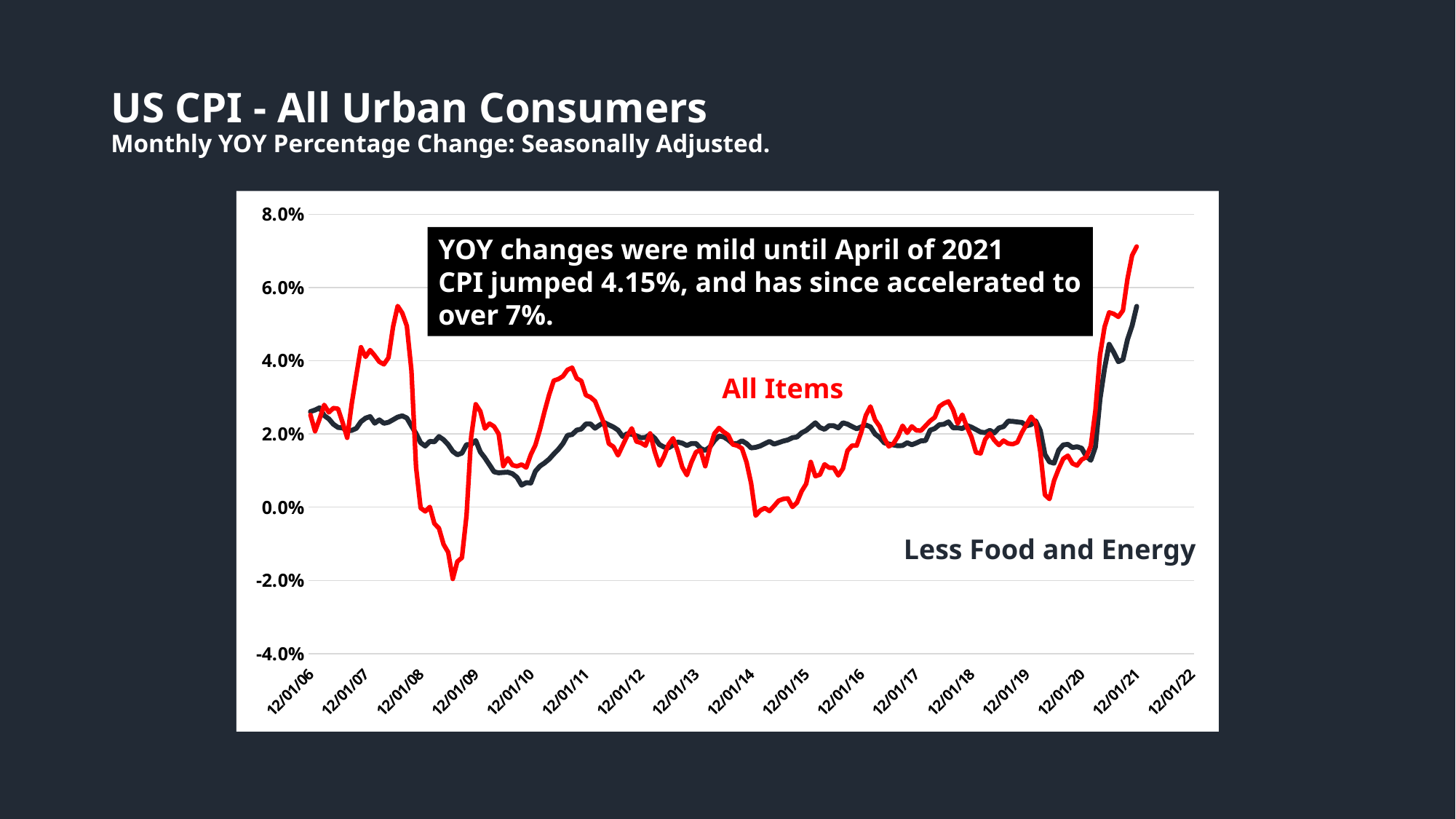
Which colour is used for the All Items series? red Is the lowest value of the All Items series, reached around 12/01/09, greater or less than 0.0%? less Which series reaches the highest value on the chart? All Items Does the All Items series rise or fall between 12/01/20 and 12/01/21? rise Is the value of the All Items series at 12/01/21 greater or less than 6.0%? greater Is the value of the Less Food and Energy series at 12/01/21 greater or less than 4.0%? greater At 12/01/21, which series has the higher value, All Items or Less Food and Energy? All Items According to the annotation on the chart, by how much did CPI jump in April of 2021? 4.15% What is the title of the slide's chart? US CPI - All Urban Consumers What kind of chart is shown on the slide? line chart Which series falls below 0.0% on the chart? All Items How many series are plotted on the chart? 2